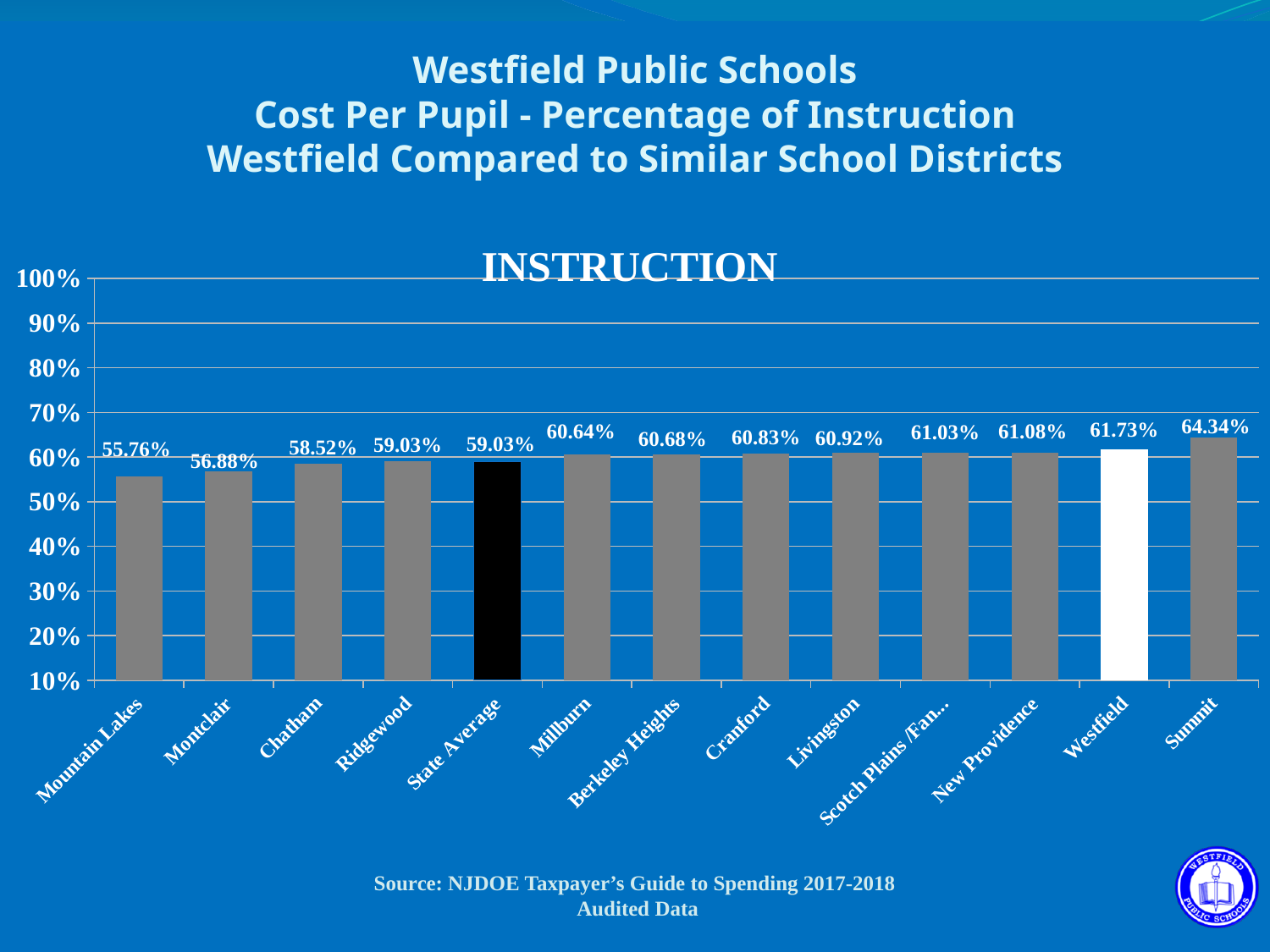
What is the difference between Westfield and the State Average? 2.70 percentage points Which is larger, the value for Montclair or the value for Chatham? Chatham What is the value for State Average? 59.03% Which district has the lowest percentage of instruction? Mountain Lakes What is the value for Mountain Lakes? 55.76% What kind of chart is shown on the slide? Bar chart What is the value for Westfield? 61.73% What is the title printed above the chart's plot area? INSTRUCTION What is the difference between Summit and Westfield? 2.61 percentage points How many bars are shown in the chart? 13 What is the value for Cranford? 60.83% Which district has the highest percentage of instruction? Summit